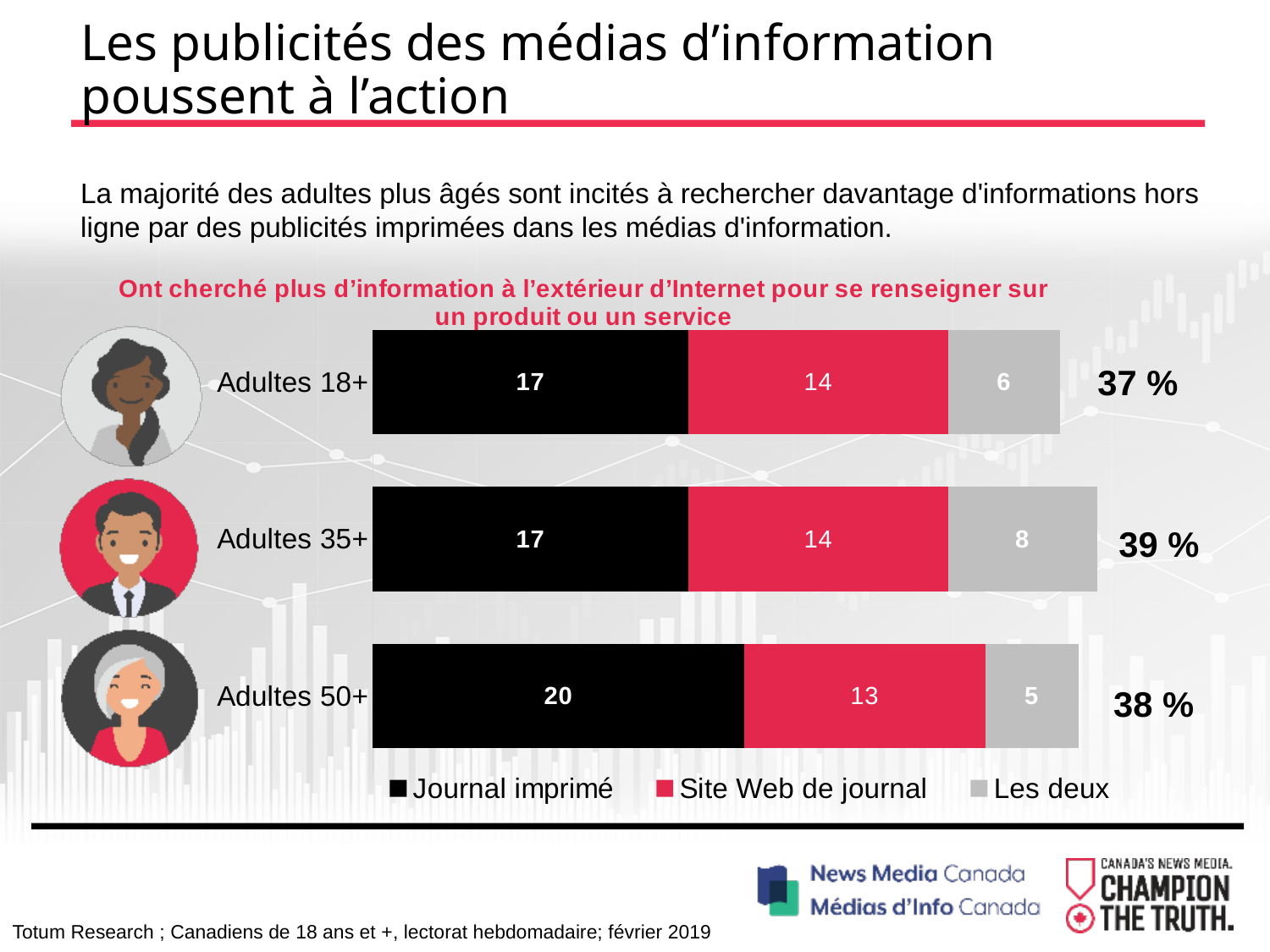
What is the value for Site Web de journal for Adultes 18+? 14 Which age group has the lowest value for Les deux? Adultes 50+ What kind of chart is shown on the slide? Stacked bar chart Which age group has the highest value for Journal imprimé? Adultes 50+ What is the value for Les deux for Adultes 35+? 8 What is the difference between the Journal imprimé values for Adultes 50+ and Adultes 18+? 3 What is the total shown for the Adultes 50+ bar? 38 % Which is larger: the Site Web de journal value for Adultes 35+ or for Adultes 50+? Adultes 35+ How many age groups are shown in the chart? 3 What is the total shown for the Adultes 35+ bar? 39 % How many series does the legend list? 3 What is the value for Journal imprimé for Adultes 50+? 20